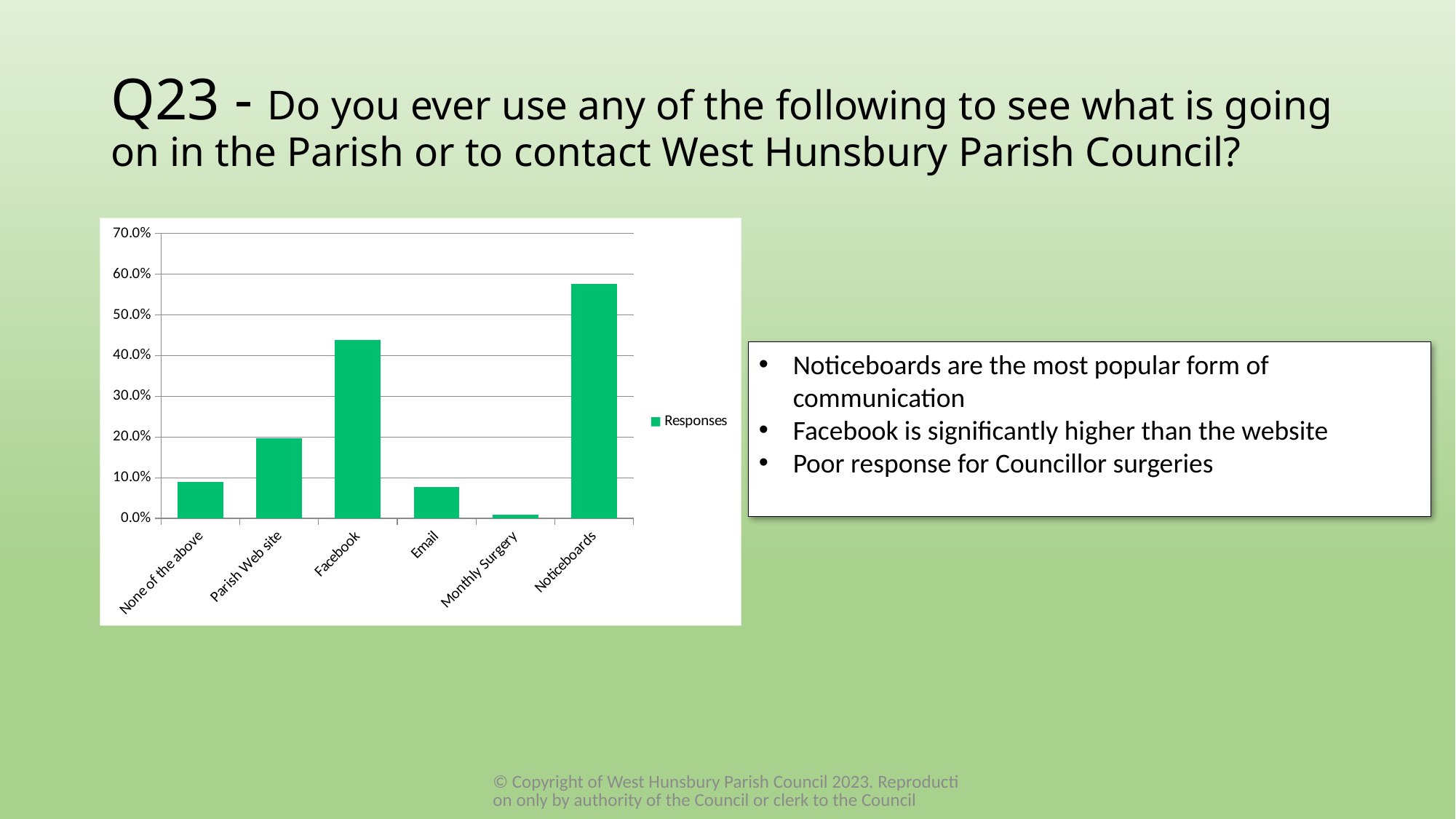
Is the value for Email greater or less than 10.0%? less Which has a higher value, None of the above or Email? None of the above How many categories are shown on the x axis of the chart? 6 Is the value for Noticeboards greater or less than 50.0%? greater Which category has the lowest value in the chart? Monthly Surgery Which has a higher value, Facebook or Parish Web site? Facebook Is the value for Monthly Surgery greater or less than 10.0%? less How many series does the chart legend list? 1 What is the name of the series shown in the chart legend? Responses Which category has the highest value in the chart? Noticeboards What kind of chart is shown on the slide? Bar chart